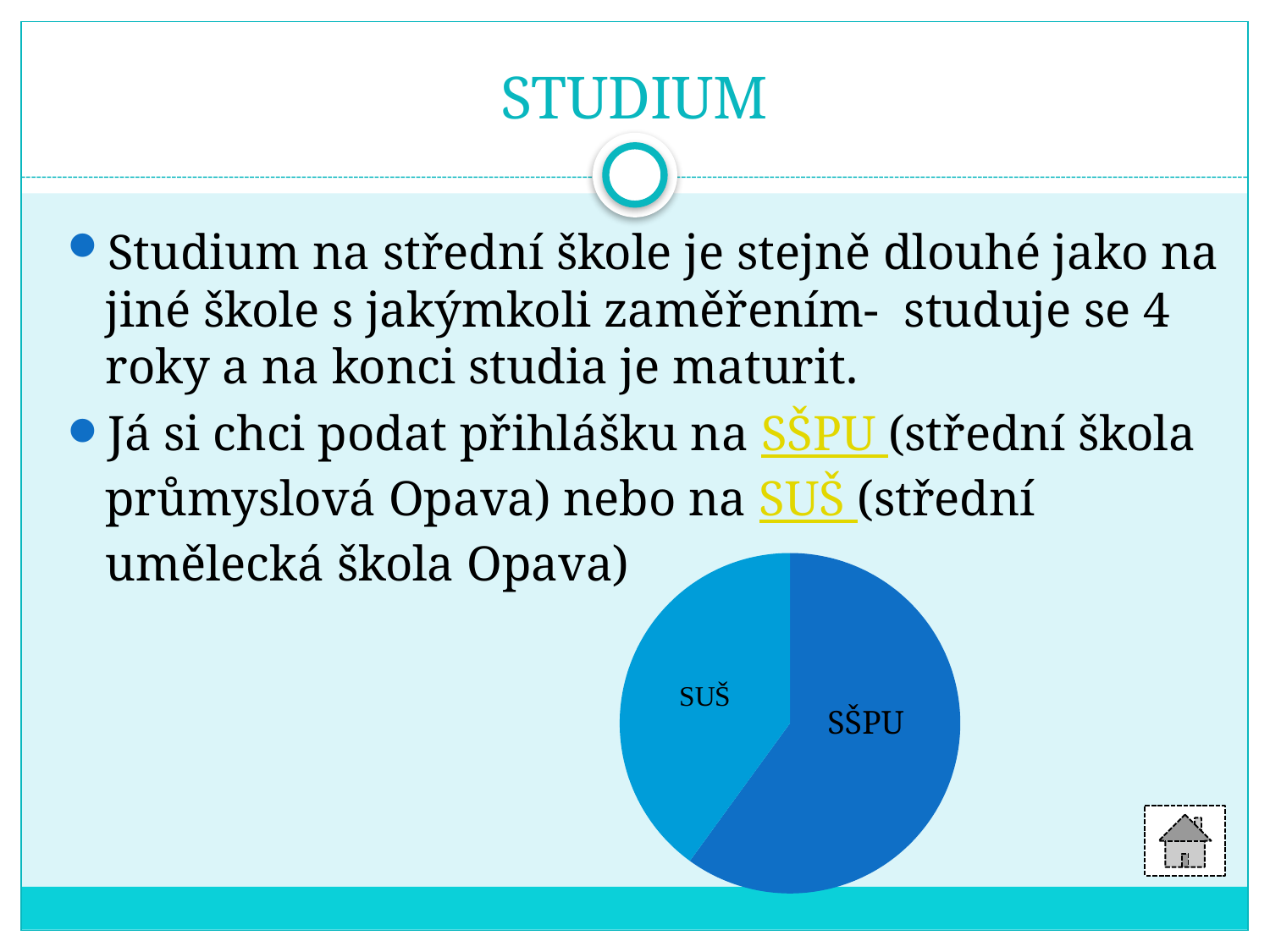
Which slice of the pie chart is the largest? SŠPU How many slices does the pie chart have? 2 Which slice is larger in the pie chart, SŠPU or SUŠ? SŠPU Which slice of the pie chart is the smallest? SUŠ What are the labels of the two slices in the pie chart? SUŠ and SŠPU Which slice of the pie chart is drawn in the darker blue colour? SŠPU What kind of chart is shown on the slide? pie chart